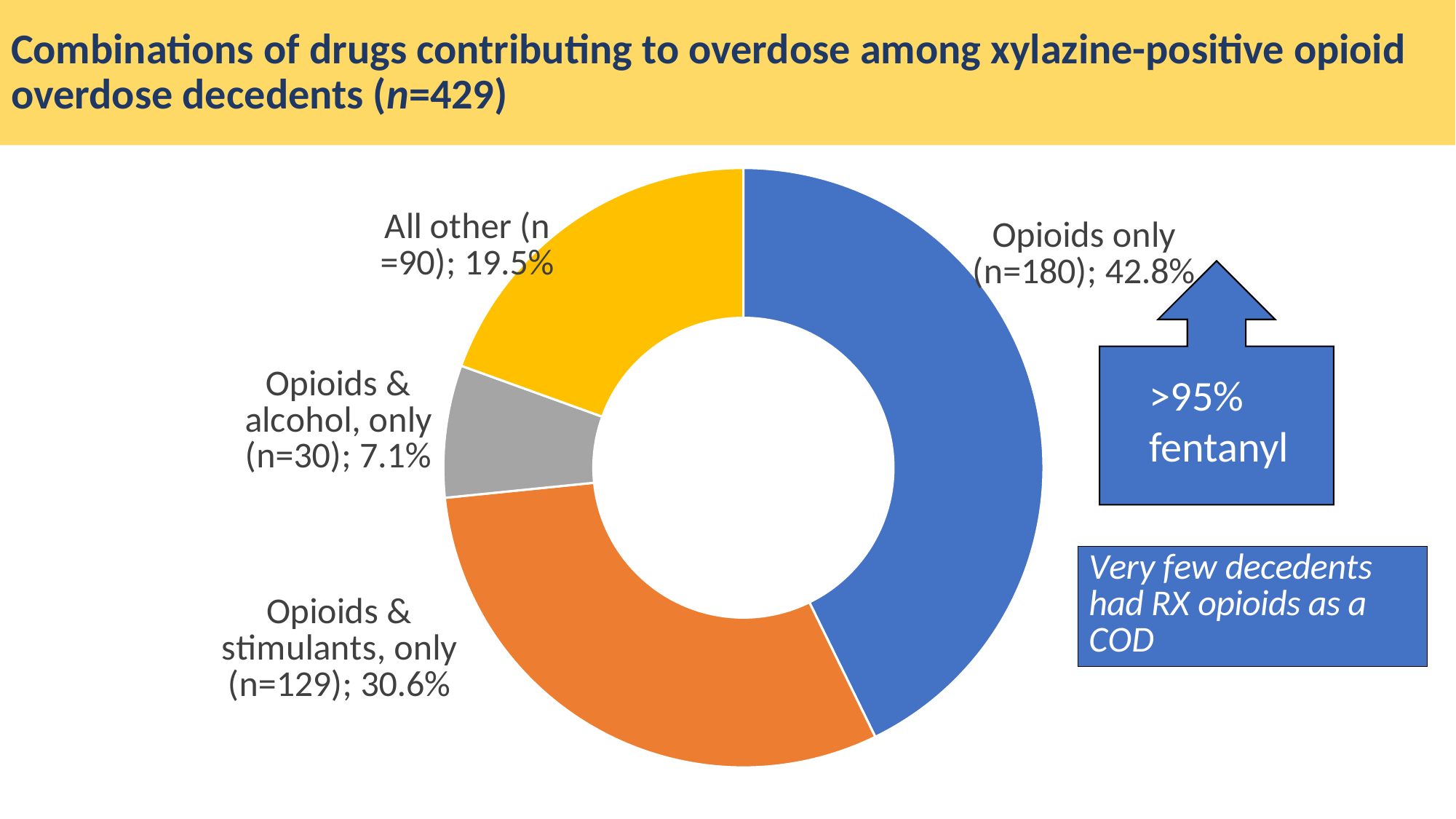
What percentage share does the 'Opioids & alcohol, only' slice represent? 7.1% How many decedents fall into the 'All other' category? 90 How many decedents are in the 'Opioids & stimulants, only' category? 129 How many categories are shown in the chart? 4 Which category has the largest share of the pie? Opioids only What is the total number of decedents (n) stated in the chart title? 429 Which category has the smallest share of the pie? Opioids & alcohol, only What is the difference in number of decedents between 'Opioids only' and 'Opioids & stimulants, only'? 51 What percentage of xylazine-positive opioid overdose decedents had opioids only as contributing drugs? 42.8% Which is larger: the share for 'All other' or the share for 'Opioids & alcohol, only'? All other What kind of chart is shown on the slide? Pie chart (doughnut) What colour is the 'Opioids & stimulants, only' slice? Orange